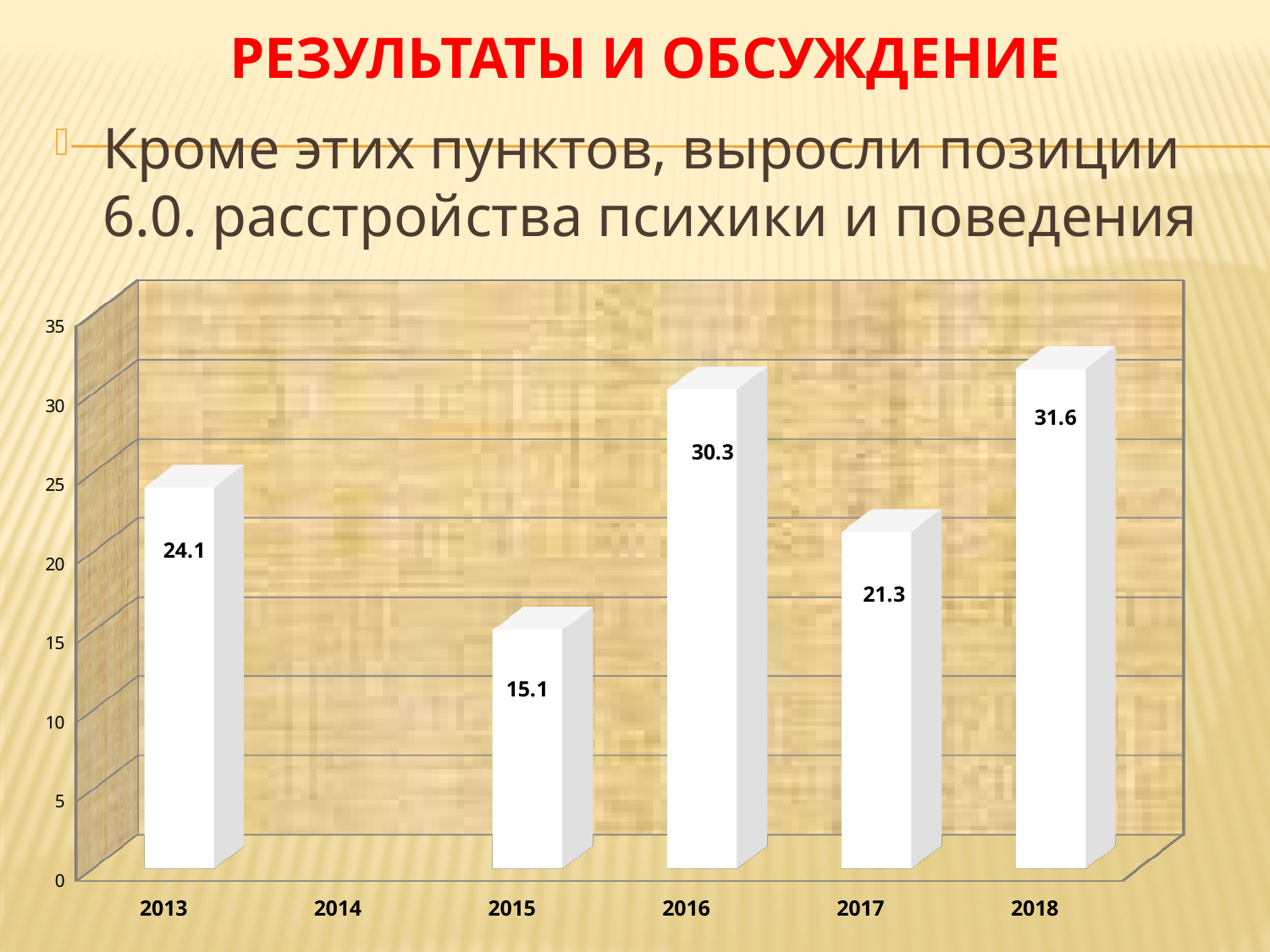
What is the value shown for 2018? 31.6 What is the value shown for 2016? 30.3 How many bars are plotted on the chart? 5 What is the difference between the values for 2016 and 2015? 15.2 What is the difference between the values for 2018 and 2016? 1.3 Which year has the highest value? 2018 What is the value shown for 2017? 21.3 What kind of chart is shown on the slide? bar chart Is the value for 2015 greater or less than 20? less Which year has the lowest value among the plotted bars? 2015 What is the value shown for 2013? 24.1 Which is larger, the value for 2013 or the value for 2017? 2013